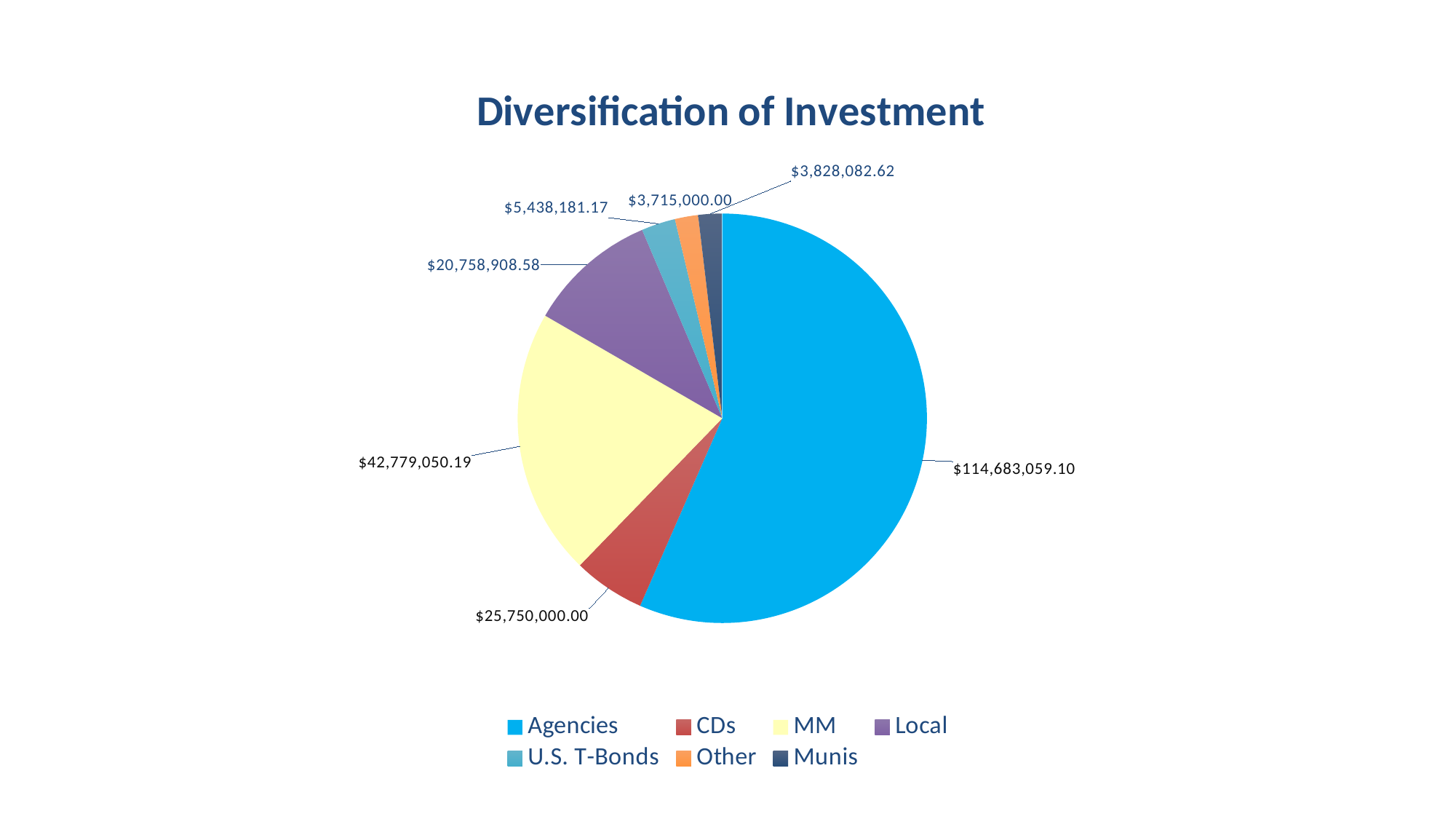
What is the difference between the MM value and the CDs value? $17,029,050.19 What is the value of the Agencies slice? $114,683,059.10 What is the value of the MM slice? $42,779,050.19 What kind of chart is shown on the slide? Pie chart What is the value of the U.S. T-Bonds slice? $5,438,181.17 What is the title of the chart? Diversification of Investment Which category has the smallest slice of the pie? Other What is the value of the Local slice? $20,758,908.58 Which category has the largest slice of the pie? Agencies What is the difference between the Munis value and the Other value? $113,082.62 How many categories does the pie chart show? 7